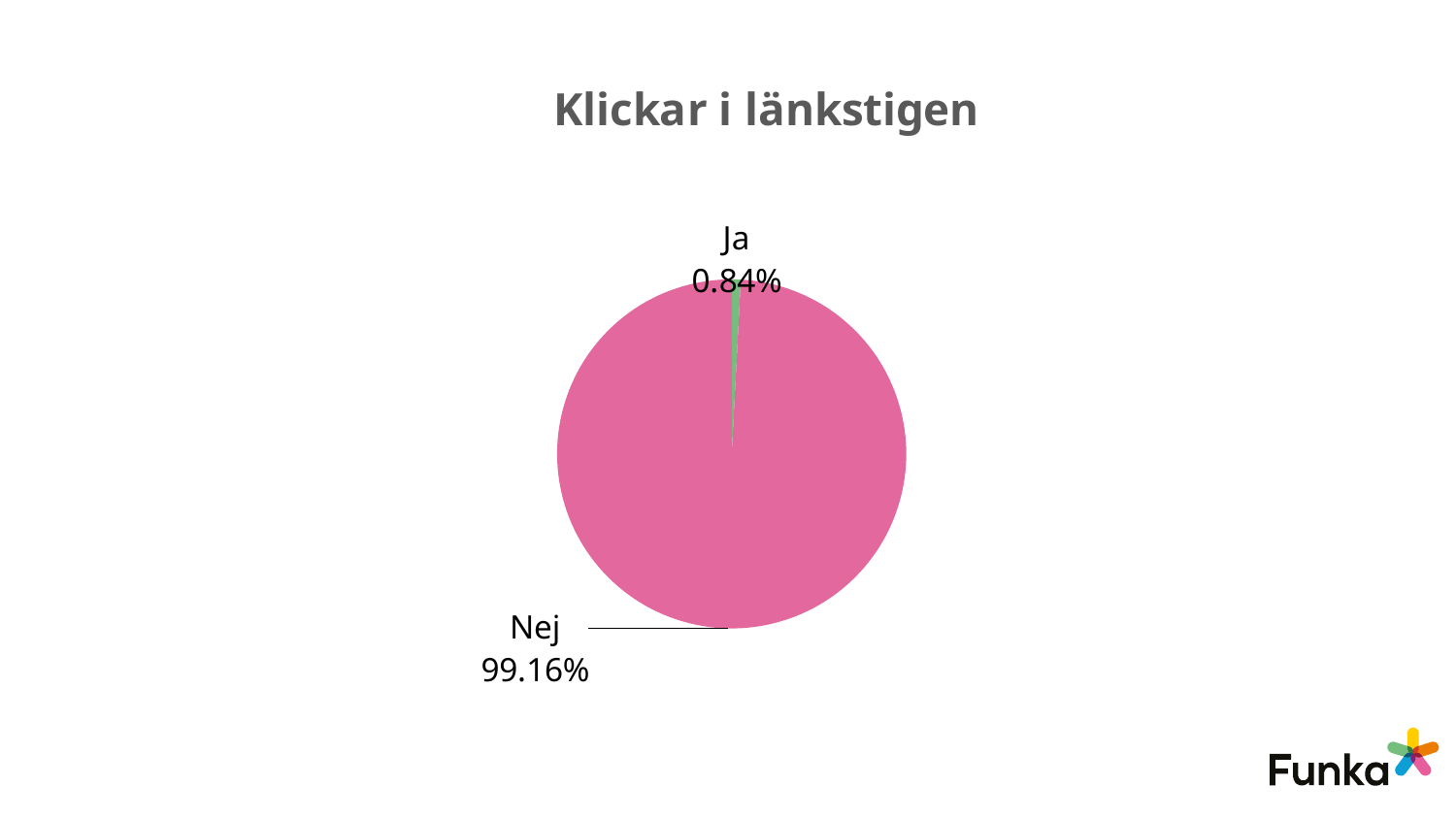
What share of the pie does the "Ja" slice represent? 0.84% What is the difference in percentage points between the "Nej" and "Ja" slices? 98.32 Which slice is the smallest in the pie chart? Ja Which slice is the largest in the pie chart? Nej Which is larger, the "Ja" slice or the "Nej" slice? Nej What kind of chart is shown on the slide? pie chart What share of the pie does the "Nej" slice represent? 99.16% How many slices does the pie chart have? 2 What is the title of the chart? Klickar i länkstigen What colour is the "Nej" slice? pink